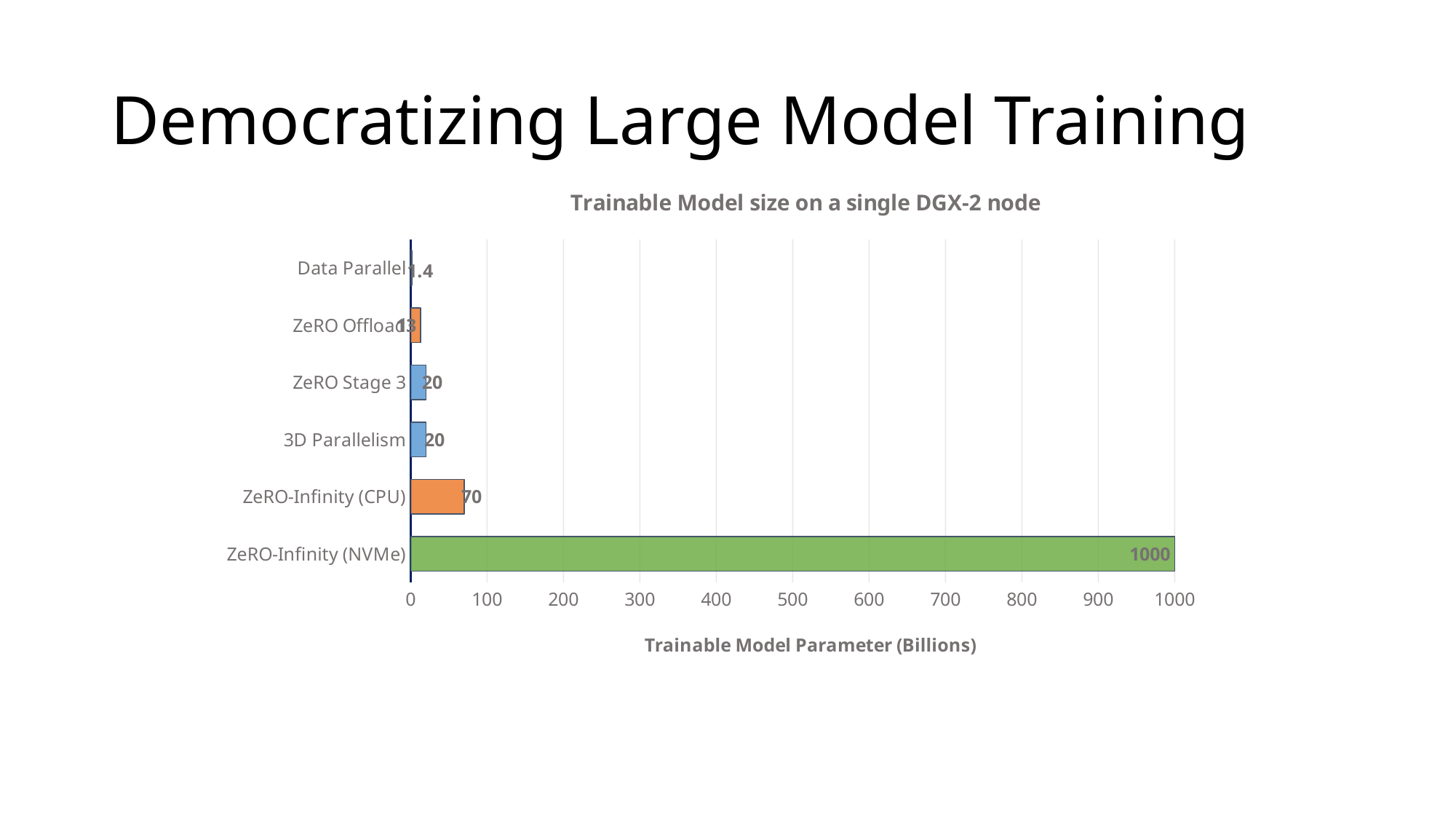
How many categories are plotted in the chart? 6 What is the x-axis label of the chart? Trainable Model Parameter (Billions) Which is larger, the value for ZeRO-Infinity (CPU) or the value for 3D Parallelism? ZeRO-Infinity (CPU) What is the value for ZeRO-Infinity (CPU)? 70 Which category has the lowest value? Data Parallel What is the value for ZeRO Stage 3? 20 Which category has the highest value? ZeRO-Infinity (NVMe) What is the title of the chart? Trainable Model size on a single DGX-2 node What is the difference between the values for ZeRO-Infinity (NVMe) and ZeRO-Infinity (CPU)? 930 What type of chart is shown on the slide? bar chart What is the value for ZeRO-Infinity (NVMe)? 1000 What is the value for Data Parallel? 1.4